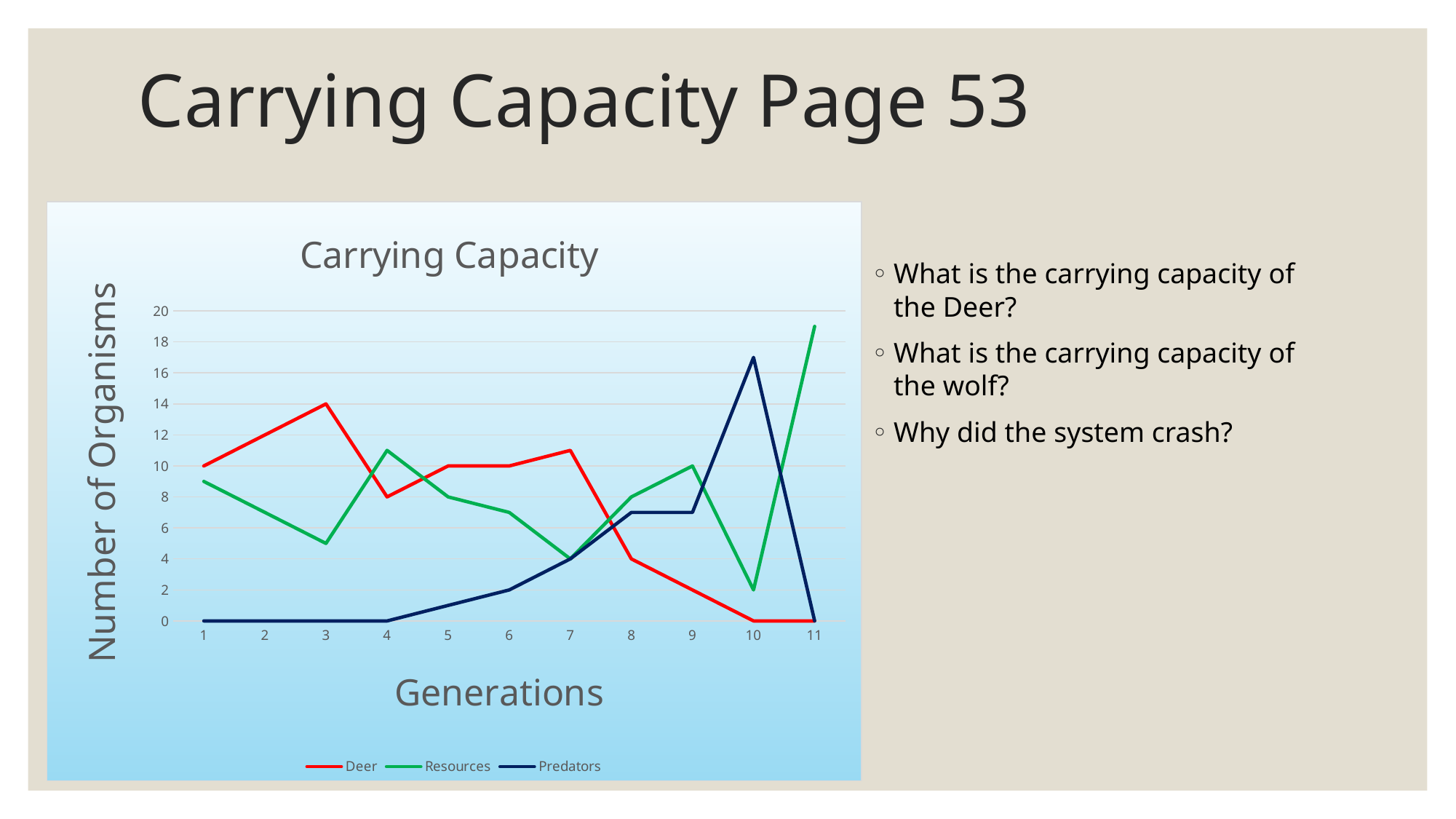
What is the value for Deer at generation 1? 10 What is the value for Deer at generation 3? 14 What is the value for Predators at generation 6? 2 Does the Deer series rise or fall from generation 7 to generation 10? fall What is the difference between the Deer value at generation 3 and the Deer value at generation 4? 6 How many generations are plotted along the x axis? 11 How many series does the chart legend list? 3 At which generation does the Predators series reach its highest value? 10 What kind of chart is shown on the slide? line chart At which generation does the Deer series reach its highest value? 3 Is the value for Predators at generation 10 greater or less than 16? greater What is the value for Resources at generation 10? 2